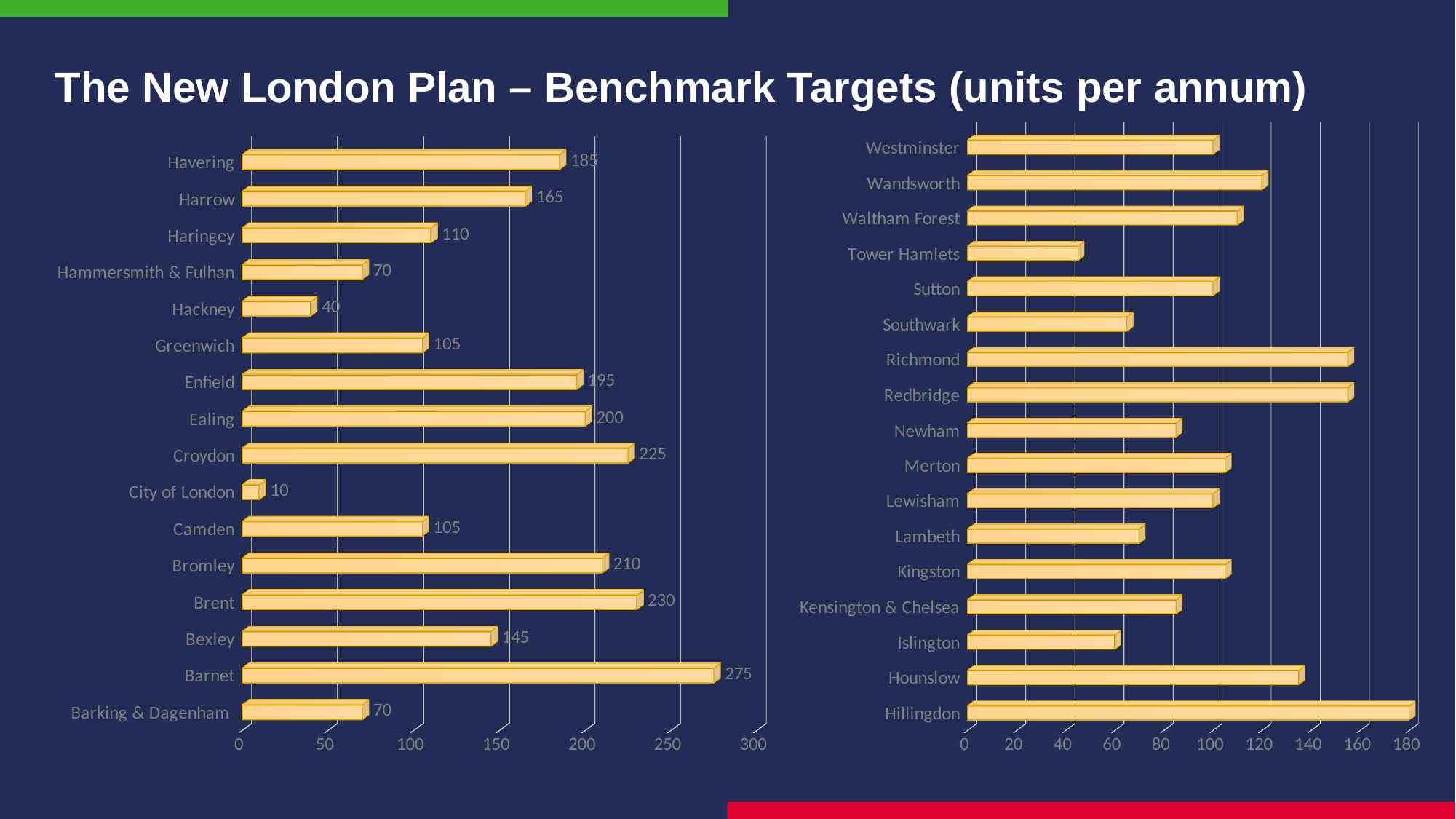
How many boroughs are shown on the right chart? 17 What kind of chart is used on the left side of the slide? Bar chart On the left chart, what is the value for Croydon? 225 On the right chart, which borough has the lowest value? Tower Hamlets On the right chart, is the value for Hounslow greater or less than 120? greater On the left chart, what is the benchmark target for Barnet? 275 On the left chart, which borough has the lowest value? City of London On the left chart, which is larger, the value for Ealing or the value for Enfield? Ealing On the left chart, what is the difference between the values for Brent and Bexley? 85 On the right chart, which borough has the highest value? Hillingdon How many boroughs are shown on the left chart? 16 On the left chart, which borough has the highest value? Barnet